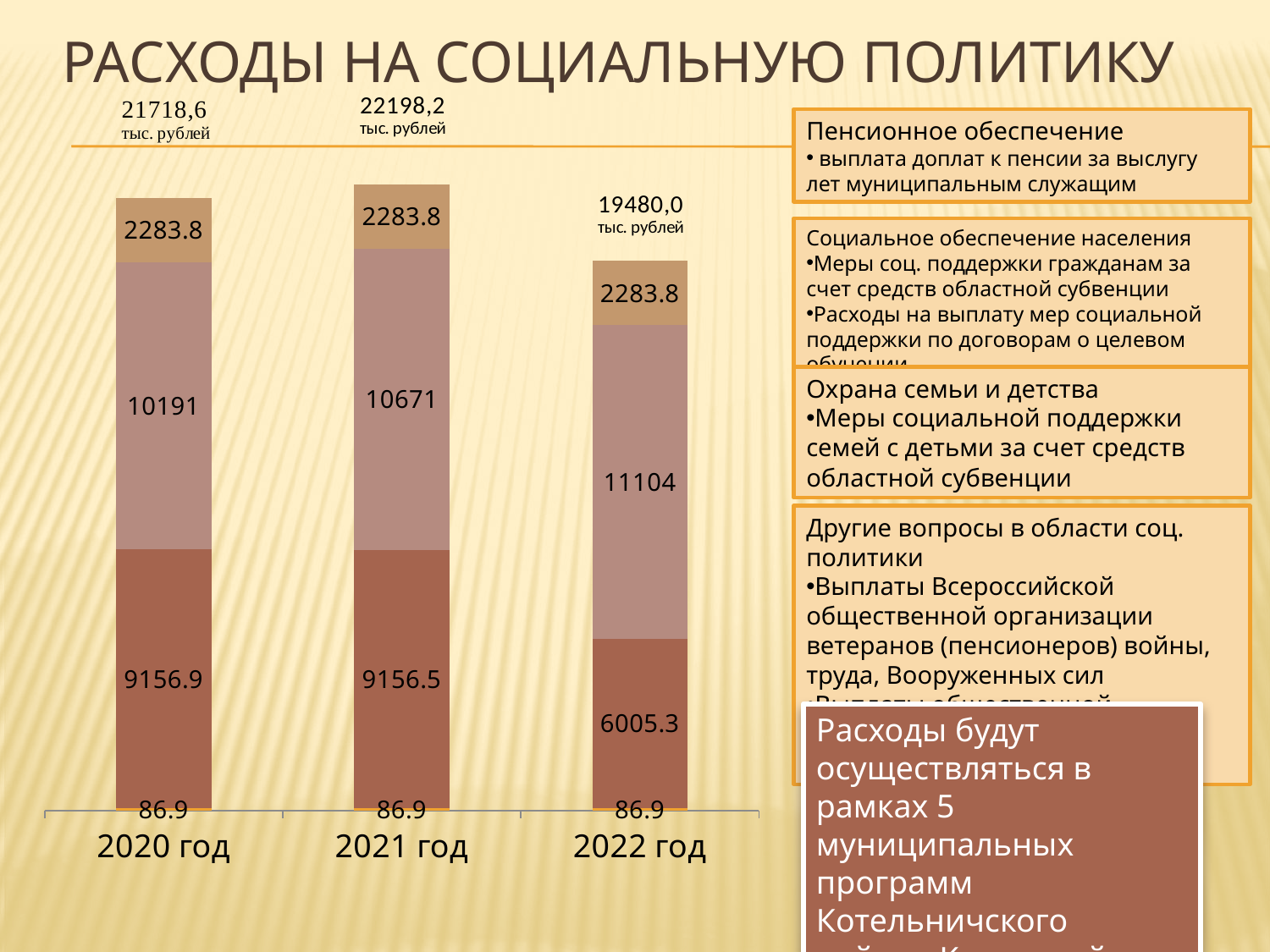
Which year has the highest total value printed above its bar? 2021 год What is the value of the top tan segment in the bar for 2021 год? 2283.8 What is the difference between the light mauve segment values for 2022 год and 2020 год? 913 What is the value of the light mauve segment in the bar for 2021 год? 10671 What is the value of the small bottom segment in the bar for 2020 год? 86.9 What is the total value printed above the bar for 2022 год? 19480,0 тыс. рублей Which year has the lowest total value printed above its bar? 2022 год What kind of chart is shown on the slide? Stacked bar chart What is the value of the dark brown segment in the bar for 2022 год? 6005.3 Which is larger: the dark brown segment for 2020 год or for 2022 год? 2020 год How many bars (years) are shown in the chart? 3 What is the total value printed above the bar for 2020 год? 21718,6 тыс. рублей